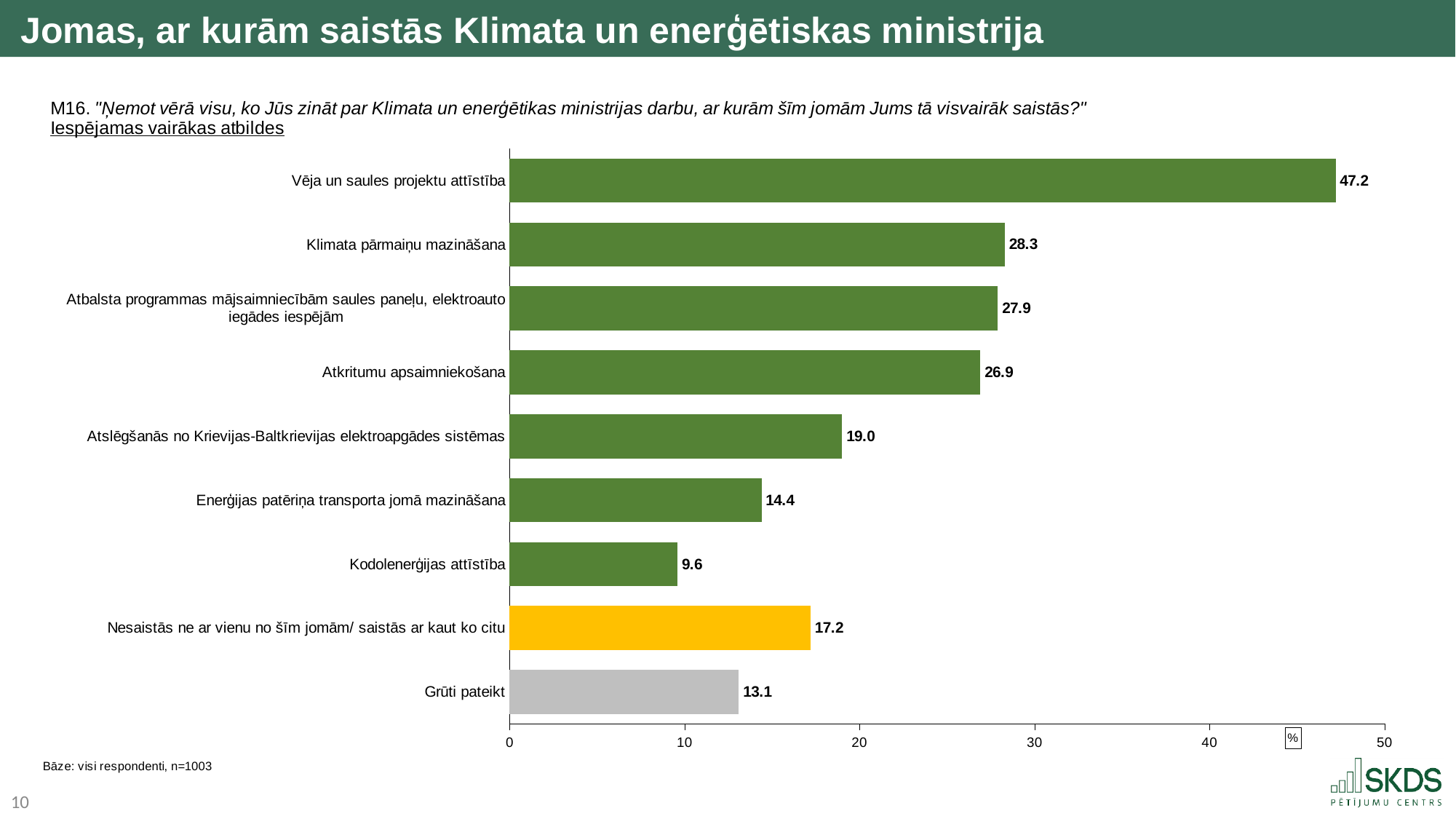
What colour is the bar for "Grūti pateikt"? grey What is the difference between the values for "Vēja un saules projektu attīstība" and "Klimata pārmaiņu mazināšana"? 18.9 Which is larger: the value for "Grūti pateikt" or the value for "Kodolenerģijas attīstība"? Grūti pateikt How many categories are shown in the chart? 9 What kind of chart is shown on the slide? bar chart What is the difference between the values for "Atslēgšanās no Krievijas-Baltkrievijas elektroapgādes sistēmas" and "Enerģijas patēriņa transporta jomā mazināšana"? 4.6 What is the value for "Nesaistās ne ar vienu no šīm jomām/ saistās ar kaut ko citu"? 17.2 What is the value for "Vēja un saules projektu attīstība"? 47.2 Which category has the lowest value? Kodolenerģijas attīstība What is the value for "Atkritumu apsaimniekošana"? 26.9 Is the value for "Klimata pārmaiņu mazināšana" greater or less than 30? less Which category has the highest value? Vēja un saules projektu attīstība